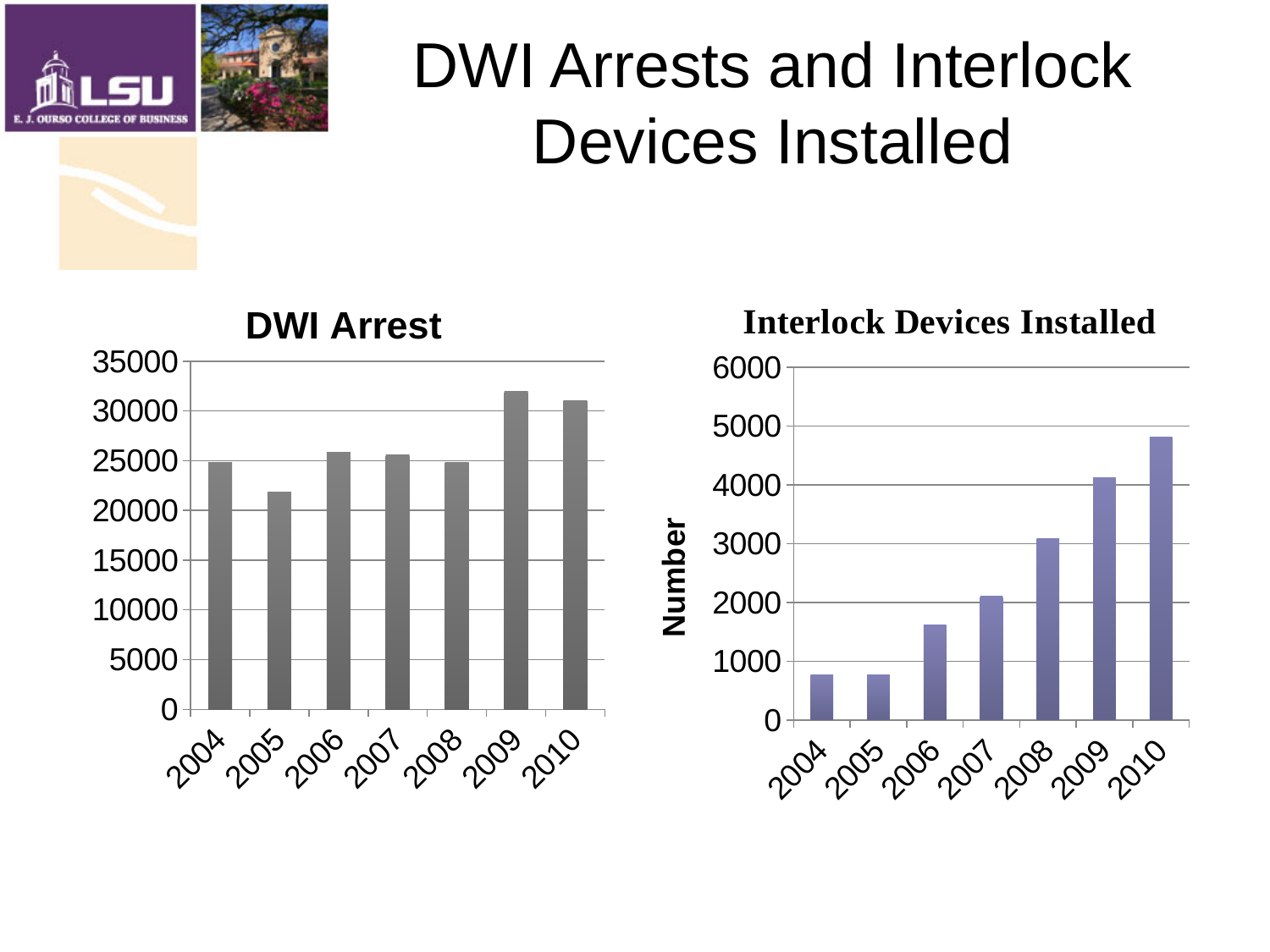
In the DWI Arrest chart, is the value for 2009 greater or less than 30000? greater In the Interlock Devices Installed chart, is the value for 2004 greater or less than 1000? less What kind of chart is the DWI Arrest chart? bar chart In the DWI Arrest chart, is the value for 2005 greater or less than 25000? less In the Interlock Devices Installed chart, which year has a higher value, 2007 or 2009? 2009 How many years are shown on the x axis of the Interlock Devices Installed chart? 7 In the DWI Arrest chart, which year has more arrests, 2006 or 2005? 2006 In the Interlock Devices Installed chart, do the values generally rise or fall from 2004 to 2010? rise In the DWI Arrest chart, which year has the lowest number of arrests? 2005 In the Interlock Devices Installed chart, which year has the highest value? 2010